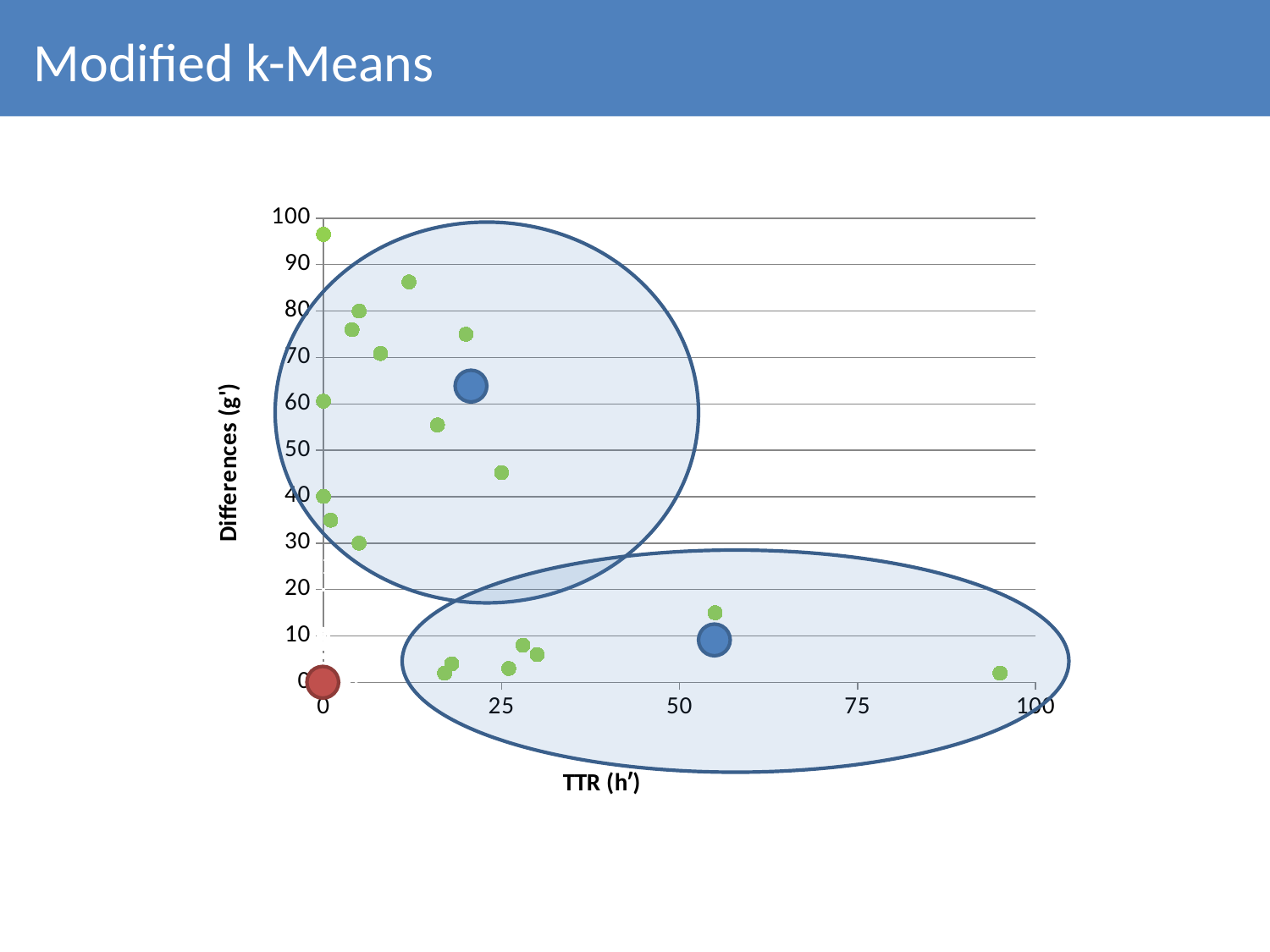
What is the title of the horizontal axis of the chart? TTR (h') Is the Differences value of the highest green point on the chart greater or less than 90? greater What kind of chart is shown on the slide? Scatter chart How many large ellipses are drawn around groups of points on the chart? 2 Which of the two blue circles has the larger Differences value, the one in the upper ellipse or the one in the lower ellipse? The one in the upper ellipse Is the TTR value of the blue circle inside the upper ellipse greater or less than 25? less Is the Differences value of the blue circle inside the upper ellipse greater or less than 50? greater How many large blue circles (cluster centres) are plotted on the chart? 2 What is the title of the vertical axis of the chart? Differences (g') What is the maximum value shown on the vertical axis of the chart? 100